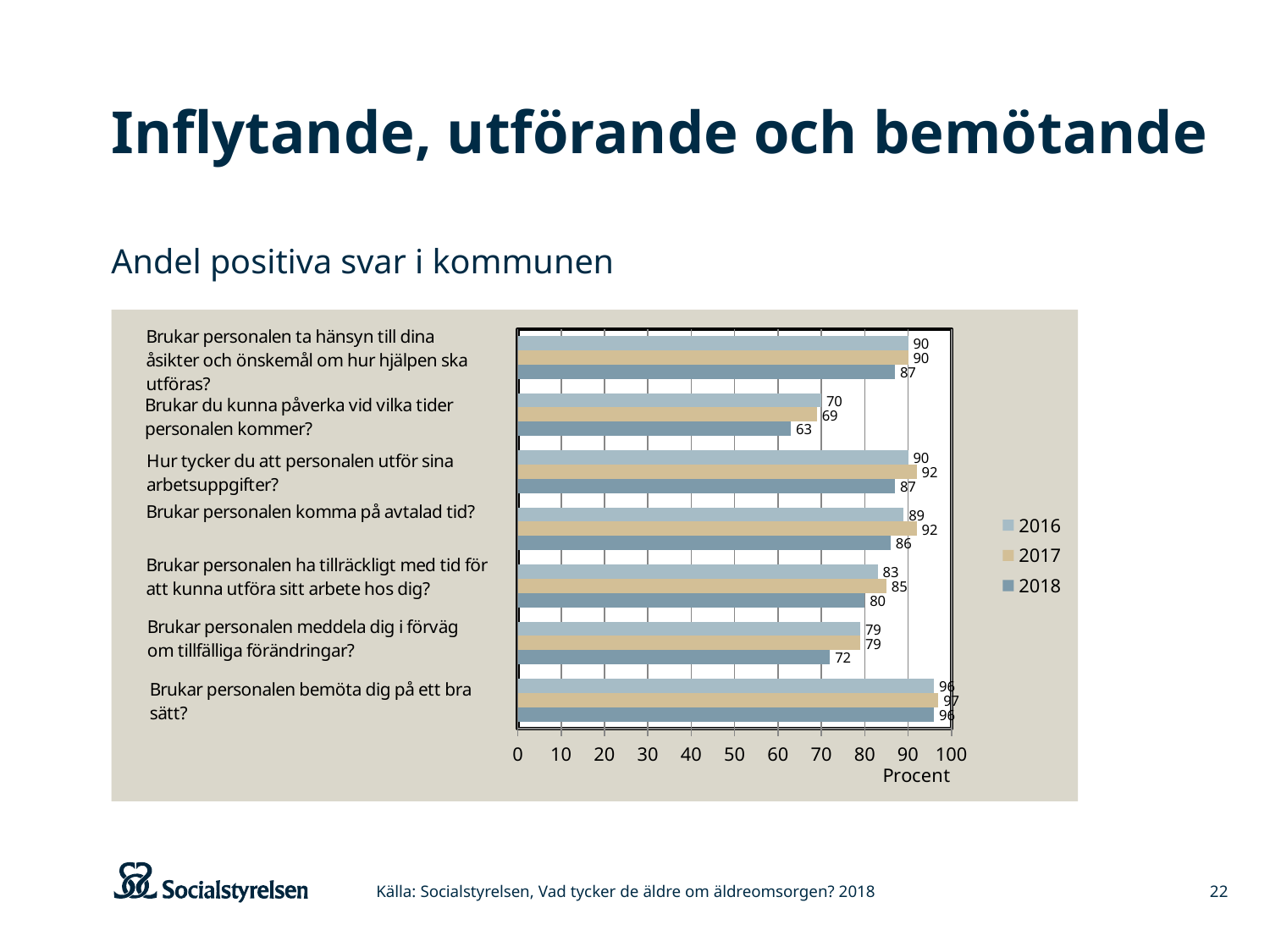
How many question categories are plotted in the chart? 7 What is the 2017 value for "Hur tycker du att personalen utför sina arbetsuppgifter?"? 92 For "Brukar personalen ha tillräckligt med tid för att kunna utföra sitt arbete hos dig?", which year has the larger value, 2017 or 2018? 2017 What is the 2018 value for "Brukar personalen ta hänsyn till dina åsikter och önskemål om hur hjälpen ska utföras?"? 87 What kind of chart is shown on the slide? bar chart What is the label on the x axis of the chart? Procent What is the 2018 value for "Brukar du kunna påverka vid vilka tider personalen kommer?"? 63 What is the 2016 value for "Brukar personalen meddela dig i förväg om tillfälliga förändringar?"? 79 Which category has the highest 2017 value? Brukar personalen bemöta dig på ett bra sätt? How many series does the legend list? 3 Which category has the lowest 2018 value? Brukar du kunna påverka vid vilka tider personalen kommer? What is the difference between the 2017 and 2018 values for "Brukar personalen komma på avtalad tid?"? 6